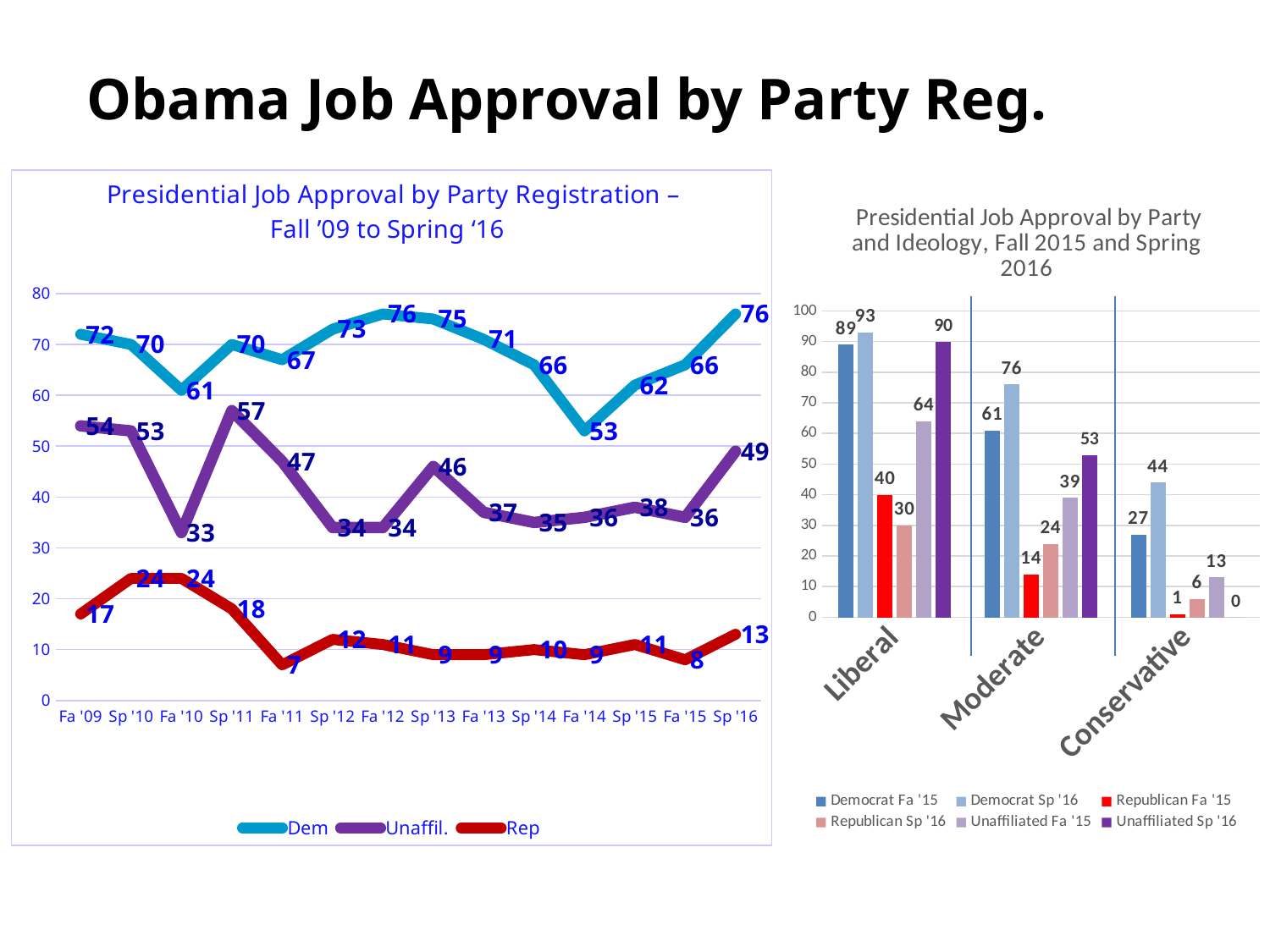
In the right chart, Presidential Job Approval by Party and Ideology, which series has the highest value for Liberal? Democrat Sp '16 In the right chart, Presidential Job Approval by Party and Ideology, which is larger for Moderate: Republican Fa '15 or Republican Sp '16? Republican Sp '16 In the left chart, Presidential Job Approval by Party Registration, what is the Dem value at Fa '14? 53 In the left chart, Presidential Job Approval by Party Registration, what is the Unaffil. value at Sp '11? 57 In the right chart, Presidential Job Approval by Party and Ideology, how many series does the legend list? 6 In the left chart, Presidential Job Approval by Party Registration, what is the Rep value at Fa '11? 7 In the left chart, Presidential Job Approval by Party Registration, how many series does the legend list? 3 In the left chart, Presidential Job Approval by Party Registration, what is the difference between the Dem and Rep values at Sp '16? 63 In the left chart, Presidential Job Approval by Party Registration, how many time points are on the x axis? 14 What kind of chart is the left chart, Presidential Job Approval by Party Registration? Line chart In the right chart, Presidential Job Approval by Party and Ideology, what is the Democrat Sp '16 value for Moderate? 76 In the right chart, Presidential Job Approval by Party and Ideology, what is the Unaffiliated Sp '16 value for Conservative? 0